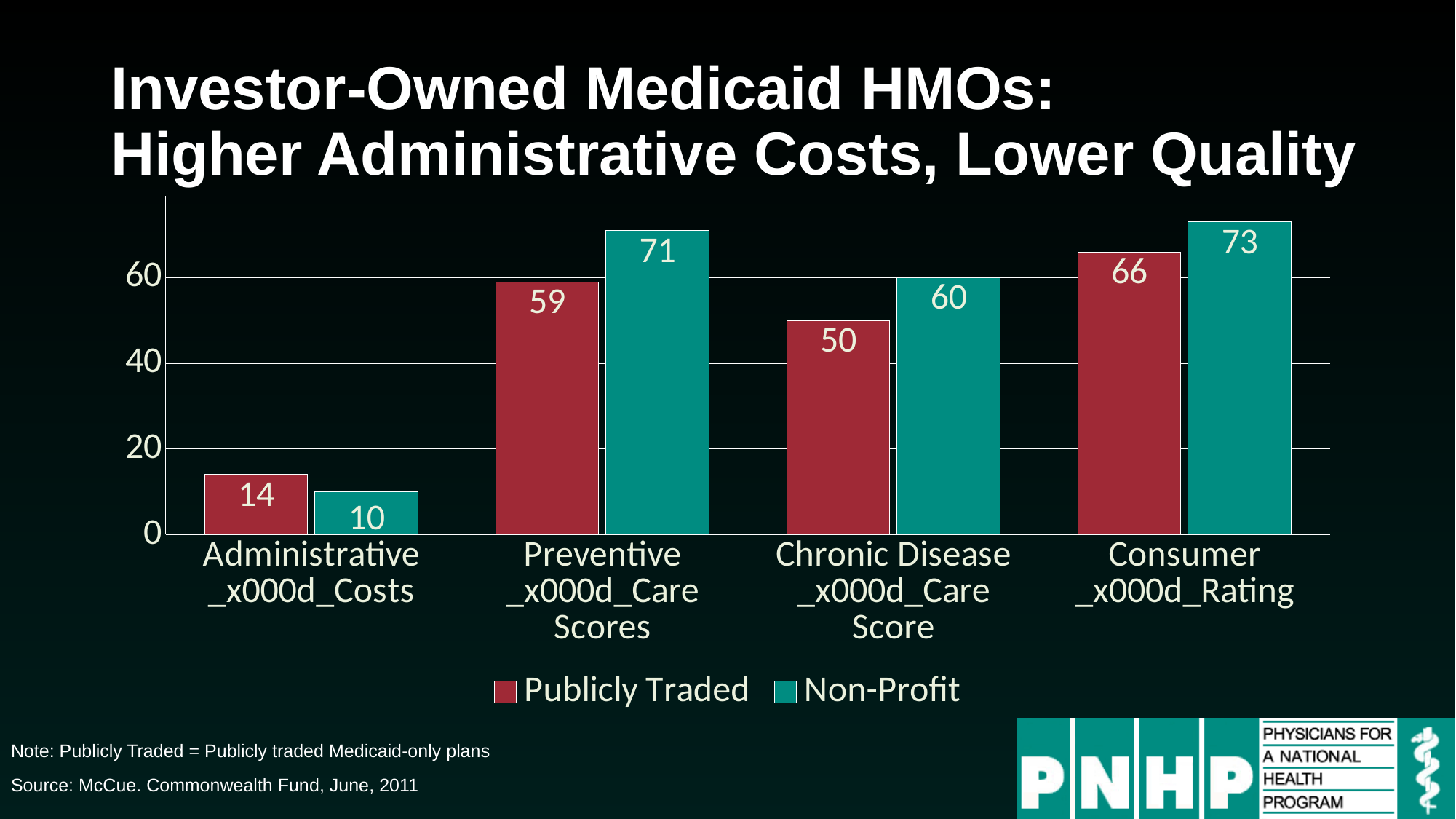
How many categories are shown on the x axis? 4 What colour are the Non-Profit bars? Teal What is the Non-Profit value for Consumer Rating? 73 What kind of chart is shown on the slide? Bar chart What is the difference between the Non-Profit and Publicly Traded values for Preventive Care Scores? 12 For Administrative Costs, which series has the larger value, Publicly Traded or Non-Profit? Publicly Traded What is the Publicly Traded value for Chronic Disease Care Score? 50 What is the Publicly Traded value for Administrative Costs? 14 Which category has the highest Non-Profit value? Consumer Rating What is the Non-Profit value for Preventive Care Scores? 71 How many series does the legend list? 2 Which category has the lowest Publicly Traded value? Administrative Costs